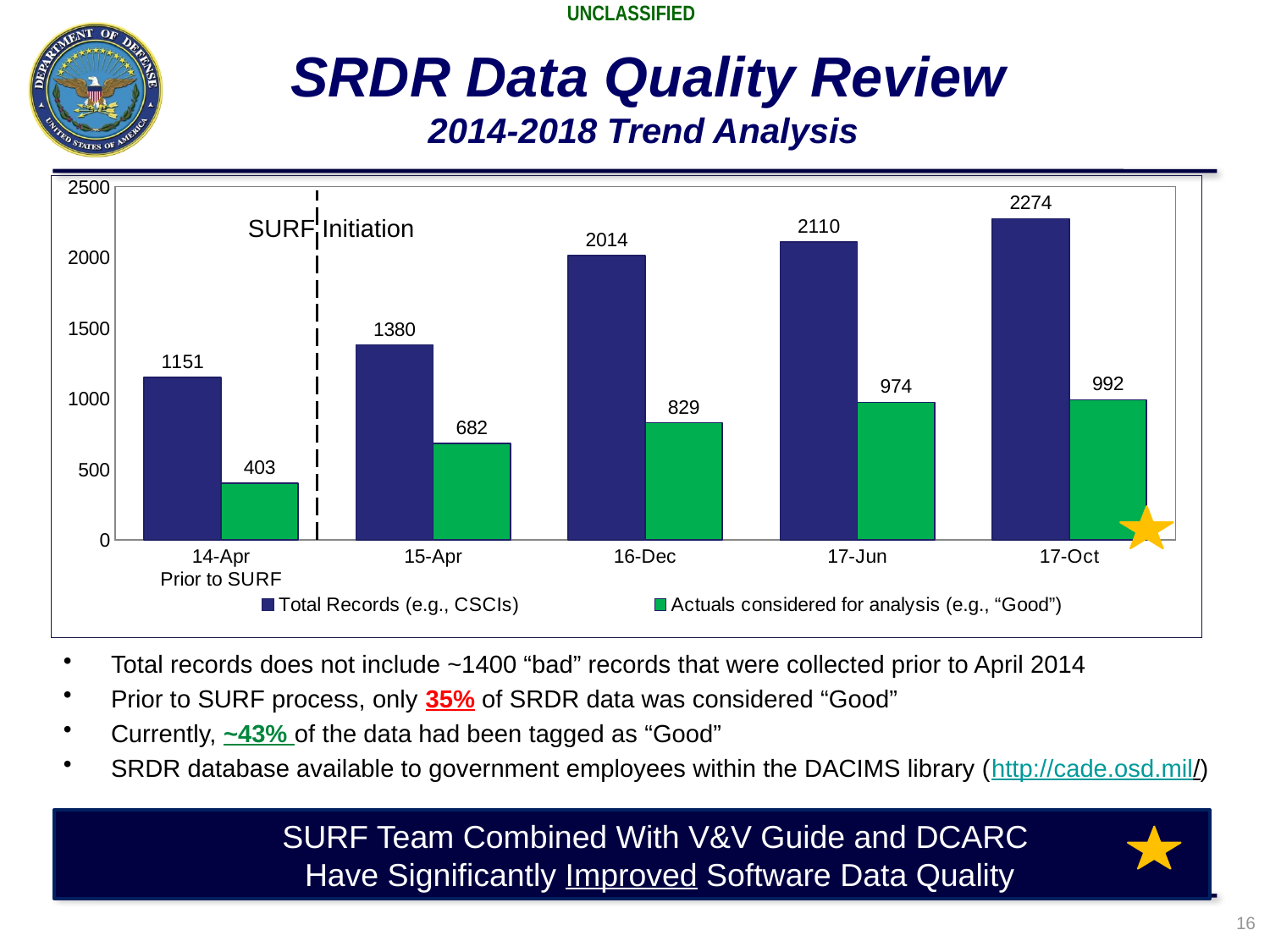
Do the Total Records values rise or fall from 14-Apr to 17-Oct? Rise Which category has the highest Total Records value? 17-Oct What is the value of Actuals considered for analysis for 17-Jun? 974 Which is larger: Total Records for 15-Apr or Actuals considered for analysis for 17-Oct? Total Records for 15-Apr How many categories are shown on the x axis? 5 What kind of chart is shown on the slide? Bar chart What does the dashed vertical line on the chart mark? SURF Initiation What is the difference between Total Records and Actuals considered for analysis for 16-Dec? 1185 Which category has the lowest Actuals considered for analysis value? 14-Apr How many series does the legend list? 2 What is the value of Total Records for 14-Apr? 1151 What is the value of Actuals considered for analysis for 15-Apr? 682